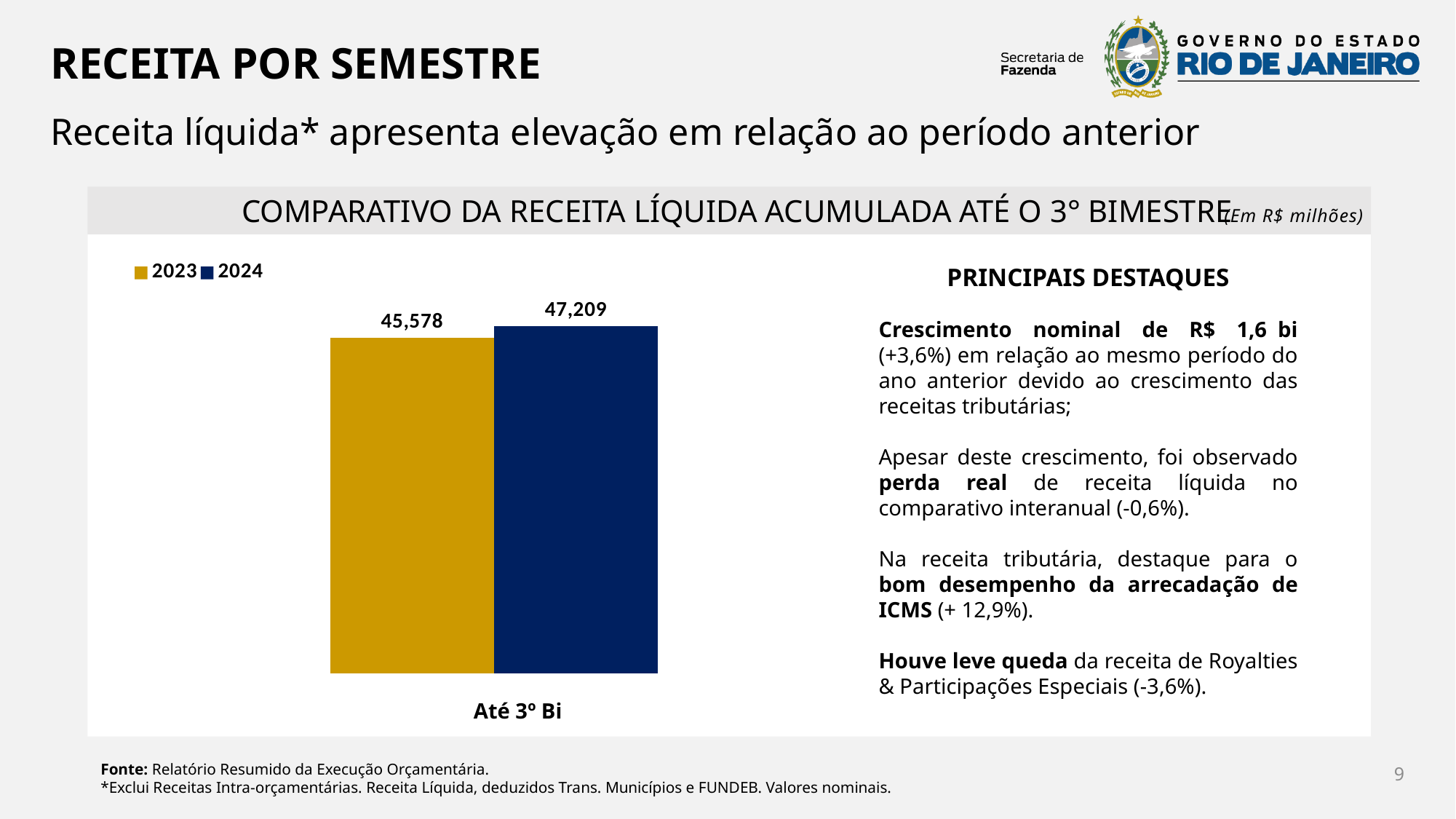
What is the value for 2023 in the 'Até 3º Bi' category? 45,578 What kind of chart is shown on the slide? Bar chart In what unit are the chart values expressed? R$ milhões Which series has the higher value for 'Até 3º Bi', 2023 or 2024? 2024 What is the difference between the 2024 and 2023 values? 1,631 What is the title of the chart? COMPARATIVO DA RECEITA LÍQUIDA ACUMULADA ATÉ O 3° BIMESTRE What is the value for 2024 in the 'Até 3º Bi' category? 47,209 Which series has the lowest value in the chart? 2023 What is the label of the category on the x axis? Até 3º Bi How many categories are shown on the x axis? 1 What colour is the bar for the 2024 series? Dark blue How many series does the legend list? 2